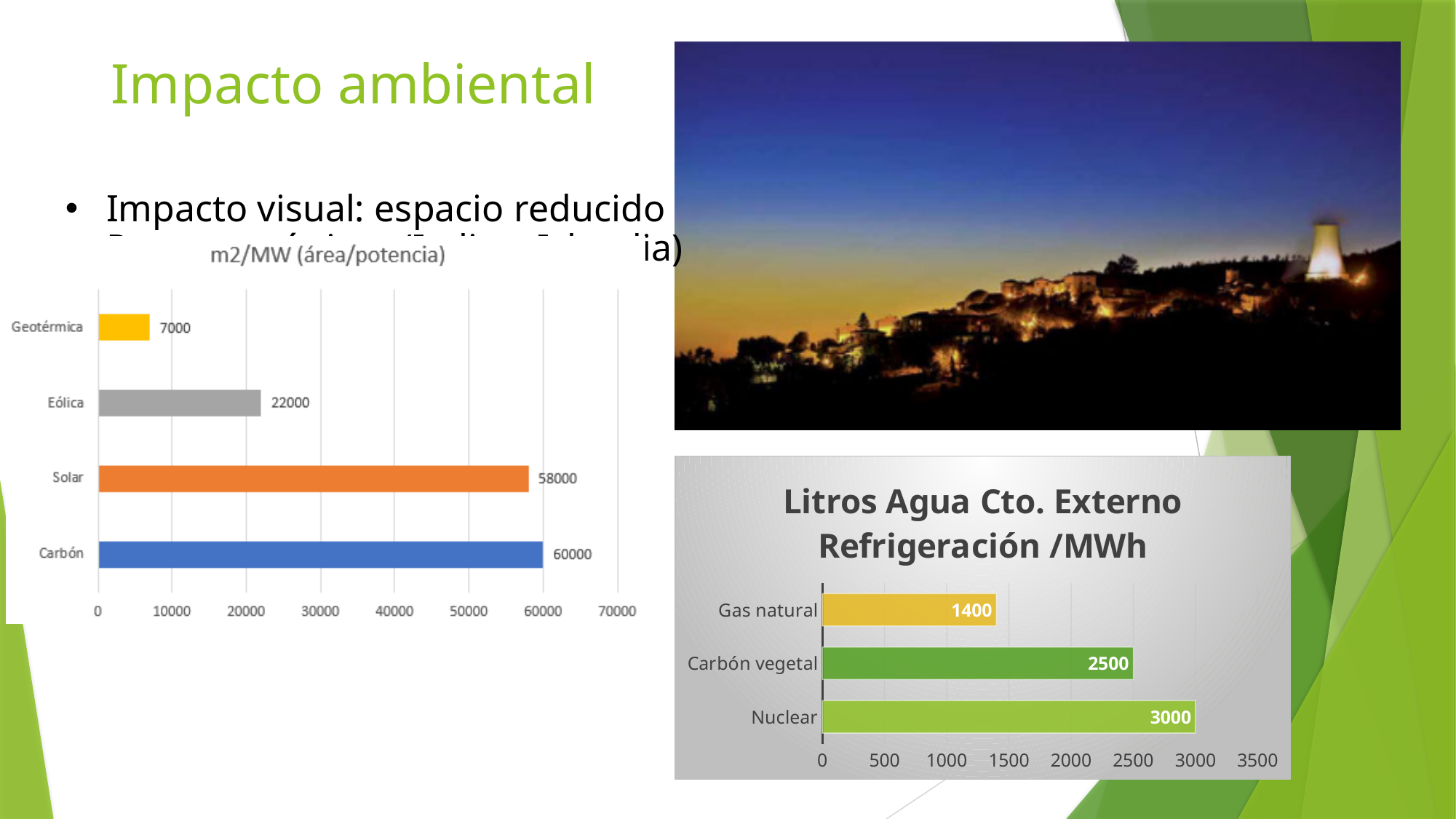
In the 'm2/MW (área/potencia)' chart, how many categories are shown? 4 In the 'Litros Agua Cto. Externo Refrigeración /MWh' chart, how many categories are shown? 3 In the 'm2/MW (área/potencia)' chart, what is the difference between the values for Eólica and Geotérmica? 15000 In the 'Litros Agua Cto. Externo Refrigeración /MWh' chart, which category has the highest value? Nuclear In the 'Litros Agua Cto. Externo Refrigeración /MWh' chart, which is larger, the value for Gas natural or the value for Carbón vegetal? Carbón vegetal In the 'm2/MW (área/potencia)' chart, what is the value for Geotérmica? 7000 In the 'm2/MW (área/potencia)' chart, which category has the highest value? Carbón What kind of chart is the 'm2/MW (área/potencia)' chart? Bar chart In the 'm2/MW (área/potencia)' chart, what is the value for Solar? 58000 In the 'Litros Agua Cto. Externo Refrigeración /MWh' chart, what is the value for Carbón vegetal? 2500 In the 'Litros Agua Cto. Externo Refrigeración /MWh' chart, what is the difference between the values for Nuclear and Gas natural? 1600 In the 'm2/MW (área/potencia)' chart, which category has the lowest value? Geotérmica